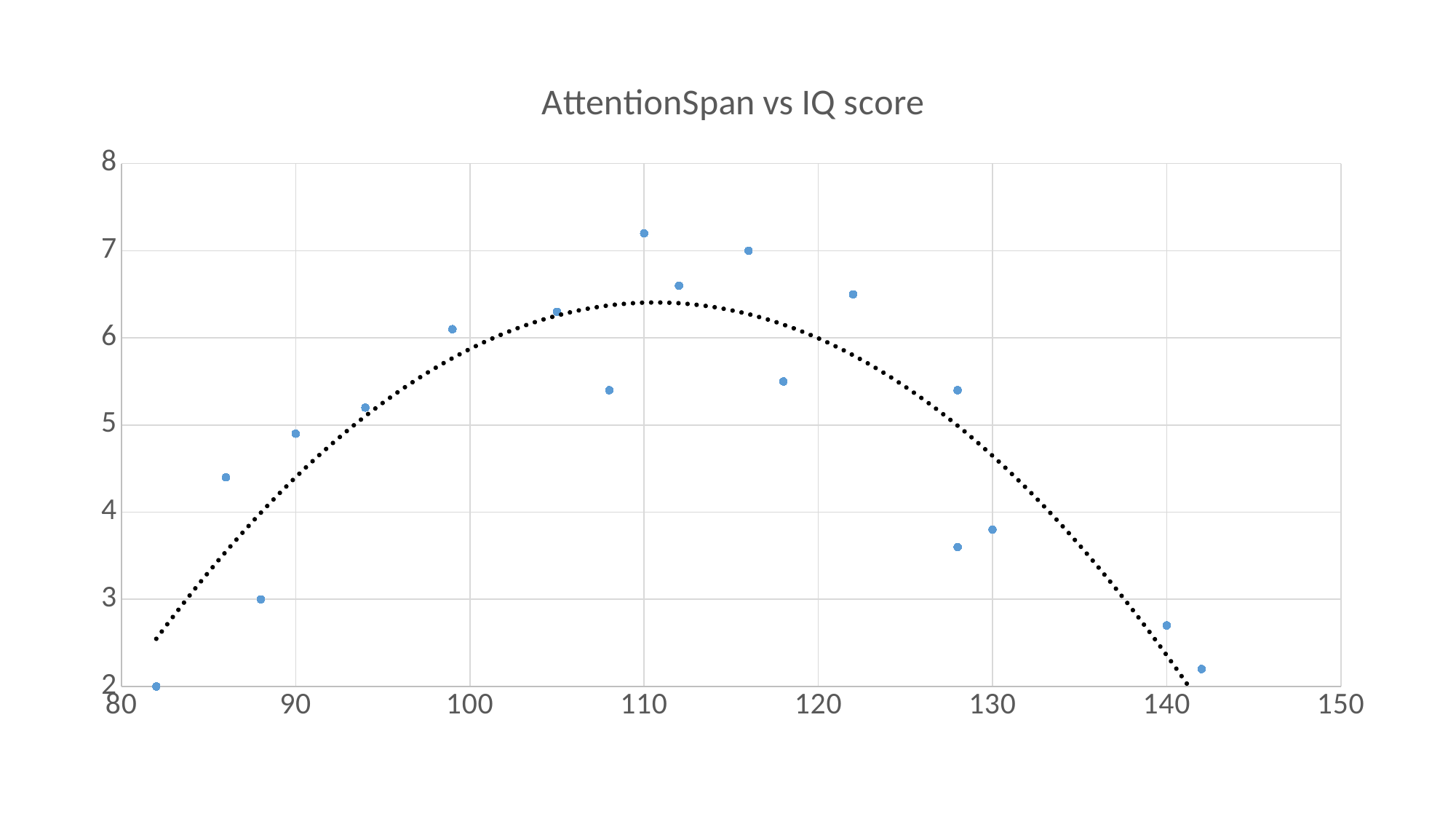
Is the attention span value of the point near IQ 140 greater or less than 3? less Does the dotted trendline rise or fall between IQ 120 and IQ 140? fall What is the highest value shown on the vertical axis? 8 What is the title of the chart? AttentionSpan vs IQ score Is the attention span value of the highest point on the chart greater or less than 7? greater Does the dotted trendline rise or fall between IQ 80 and IQ 100? rise Is the attention span value of the point near IQ 90 greater or less than 4? greater Which is larger: the attention span of the point near IQ 110 or the point near IQ 142? the point near IQ 110 What kind of chart is shown on the slide? Scatter plot How many data points are plotted on the chart? 18